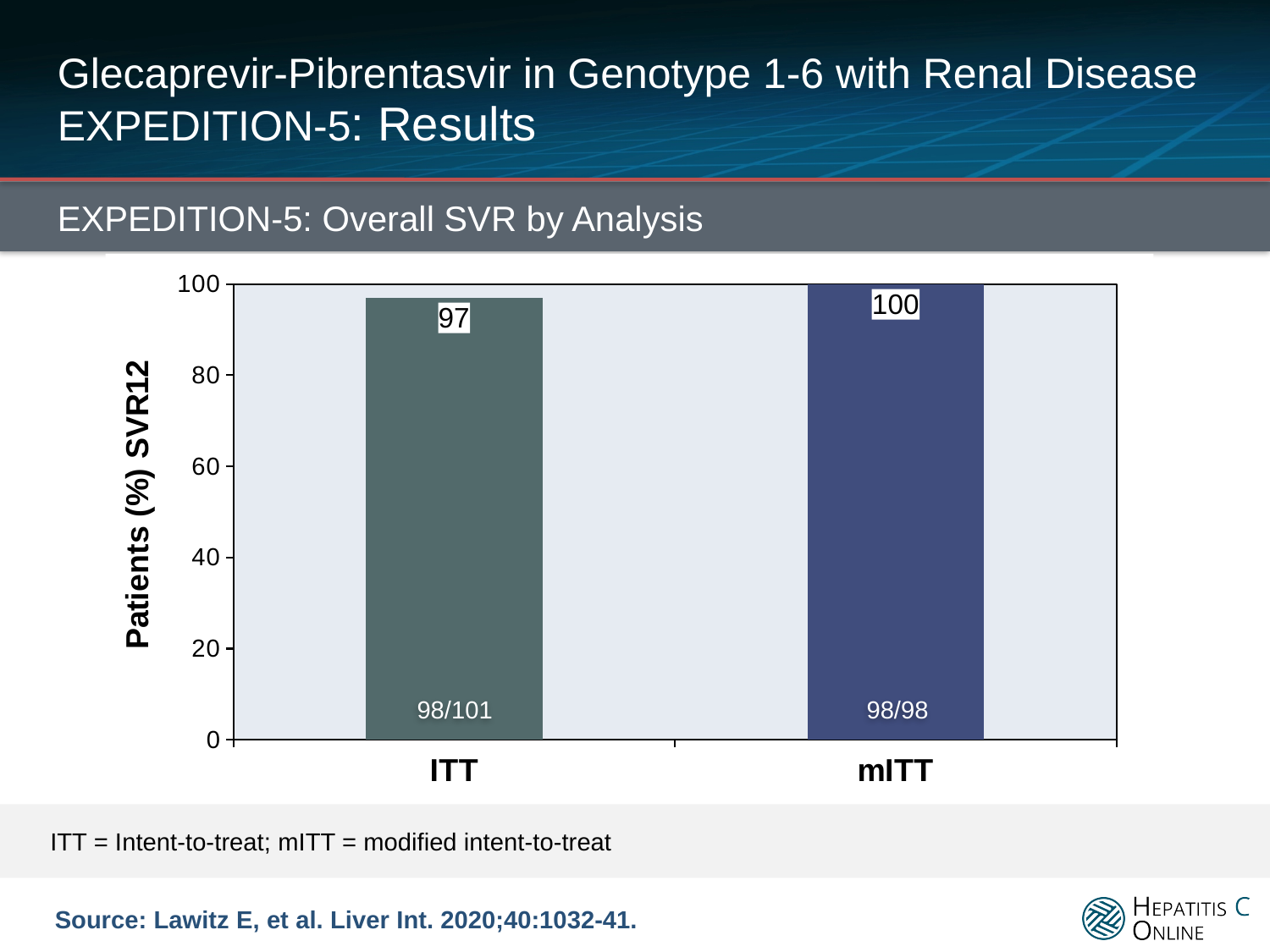
Is the value for ITT greater or less than 80? greater What is the SVR12 value for mITT? 100 What is the difference between the mITT and ITT SVR12 values? 3 What fraction of patients is printed inside the ITT bar? 98/101 Which category has the highest SVR12 value? mITT Which category has the lowest SVR12 value? ITT How many categories are shown on the x axis? 2 Which is larger, the value for ITT or the value for mITT? mITT What fraction of patients is printed inside the mITT bar? 98/98 What kind of chart is shown on the slide? Bar chart What is the SVR12 value for ITT? 97 What is the y-axis label of the chart? Patients (%) SVR12